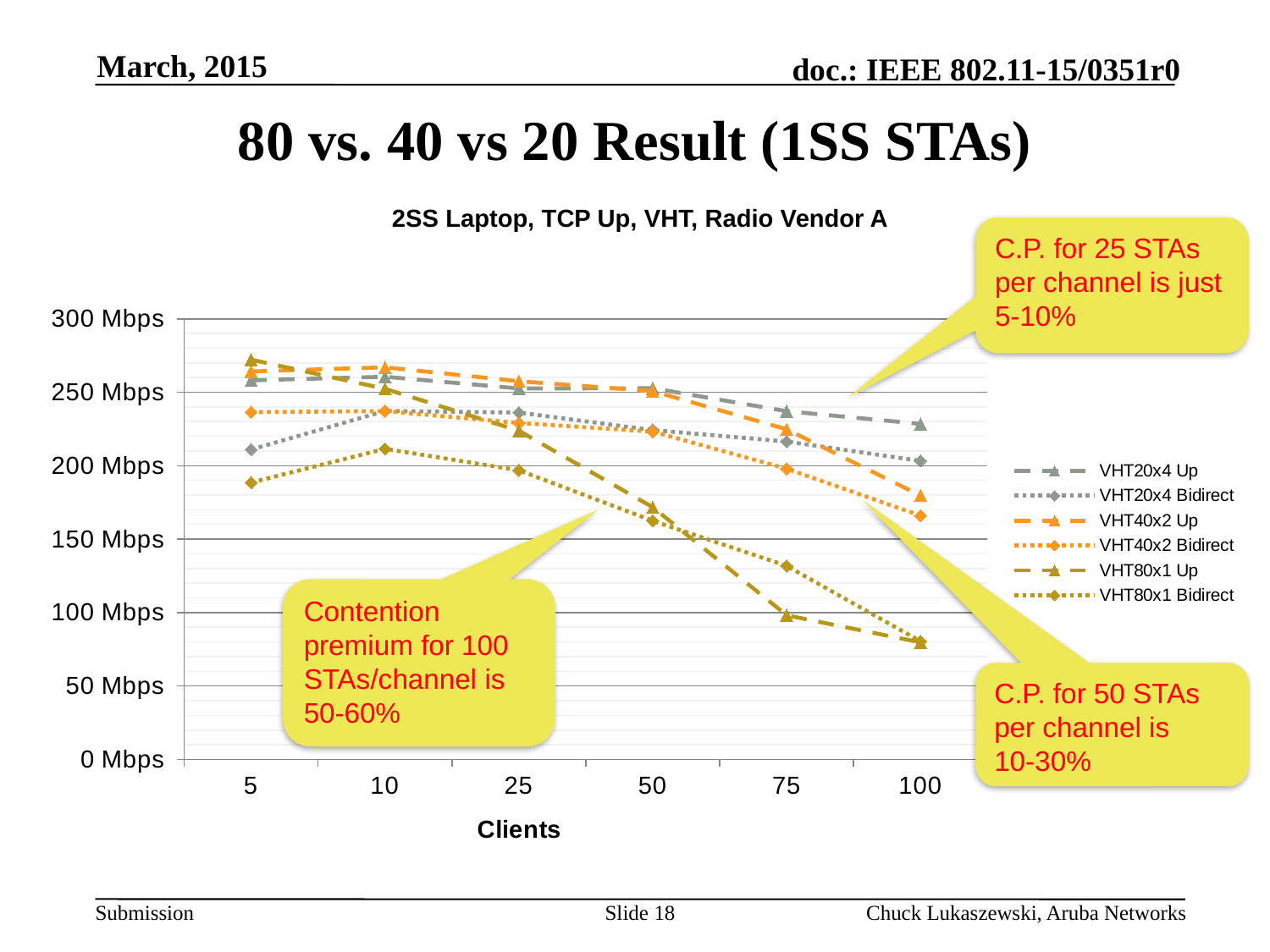
Does the VHT80x1 Up series rise or fall as the number of clients increases from 5 to 100? fall Is the value for VHT40x2 Bidirect at 100 clients greater or less than 150 Mbps? greater Which series has the highest value at 100 clients? VHT20x4 Up Is the value for VHT40x2 Up at 5 clients greater or less than 250 Mbps? greater Is the value for VHT20x4 Up at 100 clients greater or less than 200 Mbps? greater Which series has the lowest value at 5 clients? VHT80x1 Bidirect How many client counts are plotted along the x axis? 6 What kind of chart is shown on the slide? line chart What is the title of the chart? 2SS Laptop, TCP Up, VHT, Radio Vendor A At 75 clients, which is larger: VHT80x1 Up or VHT80x1 Bidirect? VHT80x1 Bidirect How many series does the legend list? 6